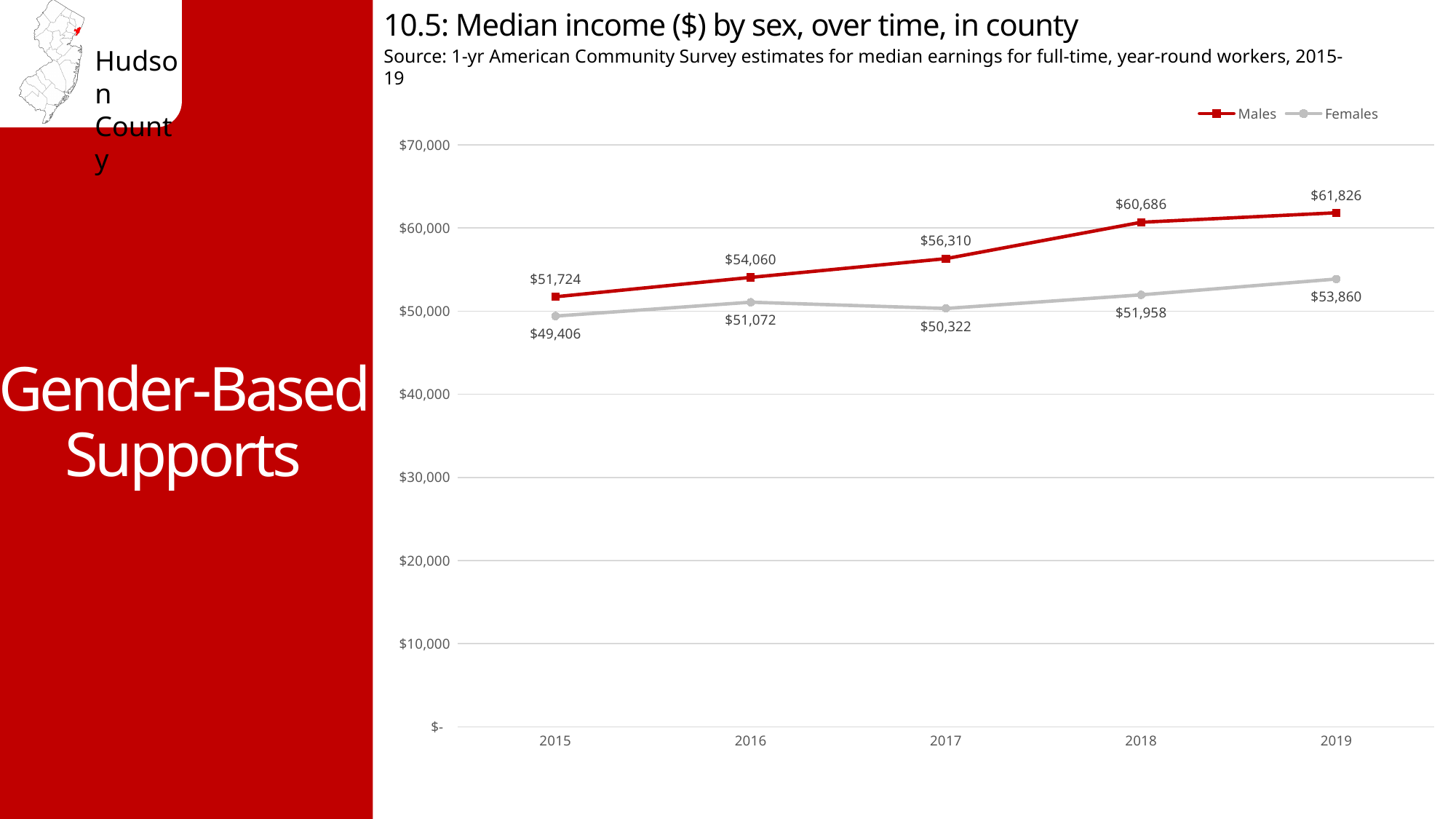
Is the median income for Males in 2018 greater or less than $60,000? greater What kind of chart is shown on the slide? line chart Which was higher in 2016, the median income for Males or for Females? Males How many series does the legend list? 2 What was the median income for Females in 2015? $49,406 What is the difference between the Males median income in 2018 and in 2015? $8,962 In which year was the median income for Males highest? 2019 What is the difference between the Males and Females median income in 2019? $7,966 What was the median income for Males in 2017? $56,310 What was the median income for Females in 2019? $53,860 In which year was the median income for Females lowest? 2015 How many years are shown on the x axis? 5